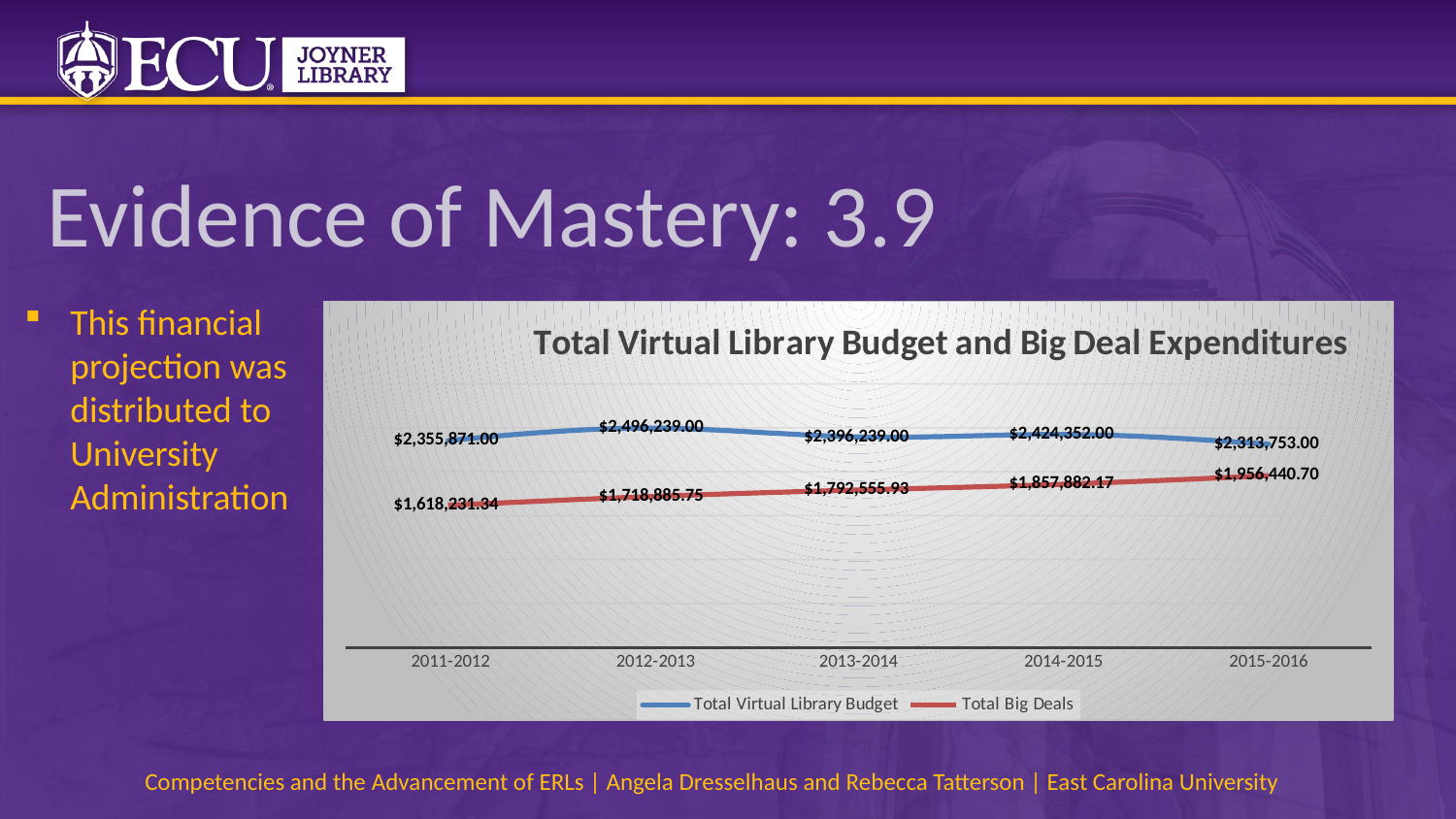
What is the difference between the Total Virtual Library Budget and Total Big Deals in 2015-2016? $357,312.30 In which year is the Total Virtual Library Budget lowest? 2015-2016 What is the Total Big Deals value for 2015-2016? $1,956,440.70 How many years are shown on the x axis? 5 What is the Total Virtual Library Budget for 2014-2015? $2,424,352.00 What is the Total Virtual Library Budget for 2012-2013? $2,496,239.00 In which year is the Total Virtual Library Budget highest? 2012-2013 Which is larger in 2013-2014, the Total Virtual Library Budget or Total Big Deals? Total Virtual Library Budget What is the Total Big Deals value for 2011-2012? $1,618,231.34 How many series does the legend list? 2 In which year is the Total Big Deals value lowest? 2011-2012 Do the Total Big Deals values rise or fall from 2011-2012 to 2015-2016? rise